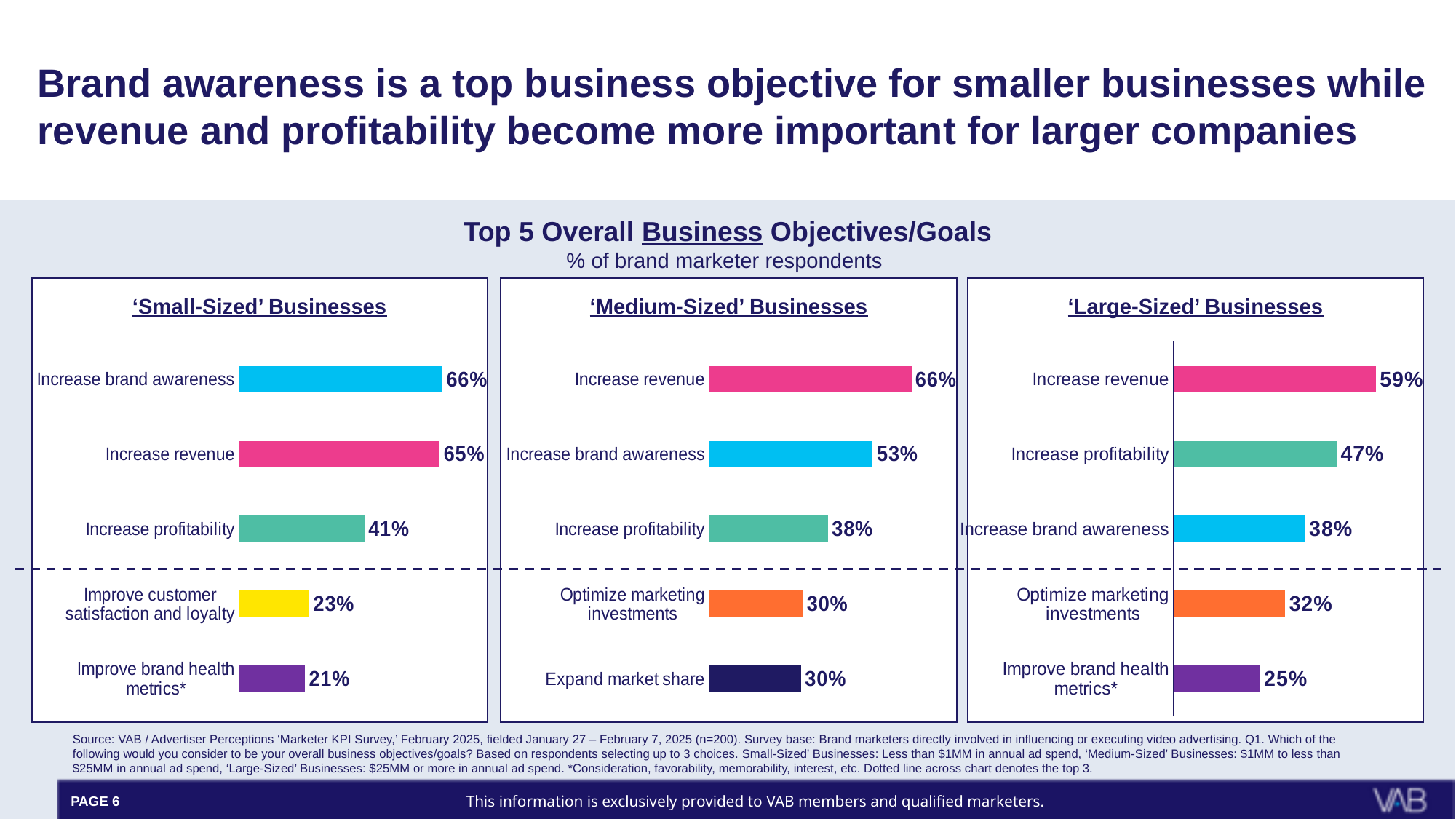
In the 'Medium-Sized' Businesses chart, what is the difference between Increase revenue and Increase brand awareness? 13 percentage points How many objectives are shown in the 'Medium-Sized' Businesses chart? 5 What does the dotted line across the charts denote? The top 3 In the 'Large-Sized' Businesses chart, which objective has the highest value? Increase revenue In the 'Large-Sized' Businesses chart, what is the value for Optimize marketing investments? 32% In the 'Small-Sized' Businesses chart, which objective has the lowest value? Improve brand health metrics* In the 'Large-Sized' Businesses chart, what is the difference between Increase revenue and Increase brand awareness? 21 percentage points What type of chart is used for the 'Large-Sized' Businesses panel? Bar chart In the 'Large-Sized' Businesses chart, what is the value for Increase profitability? 47% In the 'Small-Sized' Businesses chart, what percentage of respondents selected Increase brand awareness? 66% In the 'Medium-Sized' Businesses chart, what is the value for Increase brand awareness? 53% In the 'Small-Sized' Businesses chart, which is larger: Increase profitability or Improve customer satisfaction and loyalty? Increase profitability